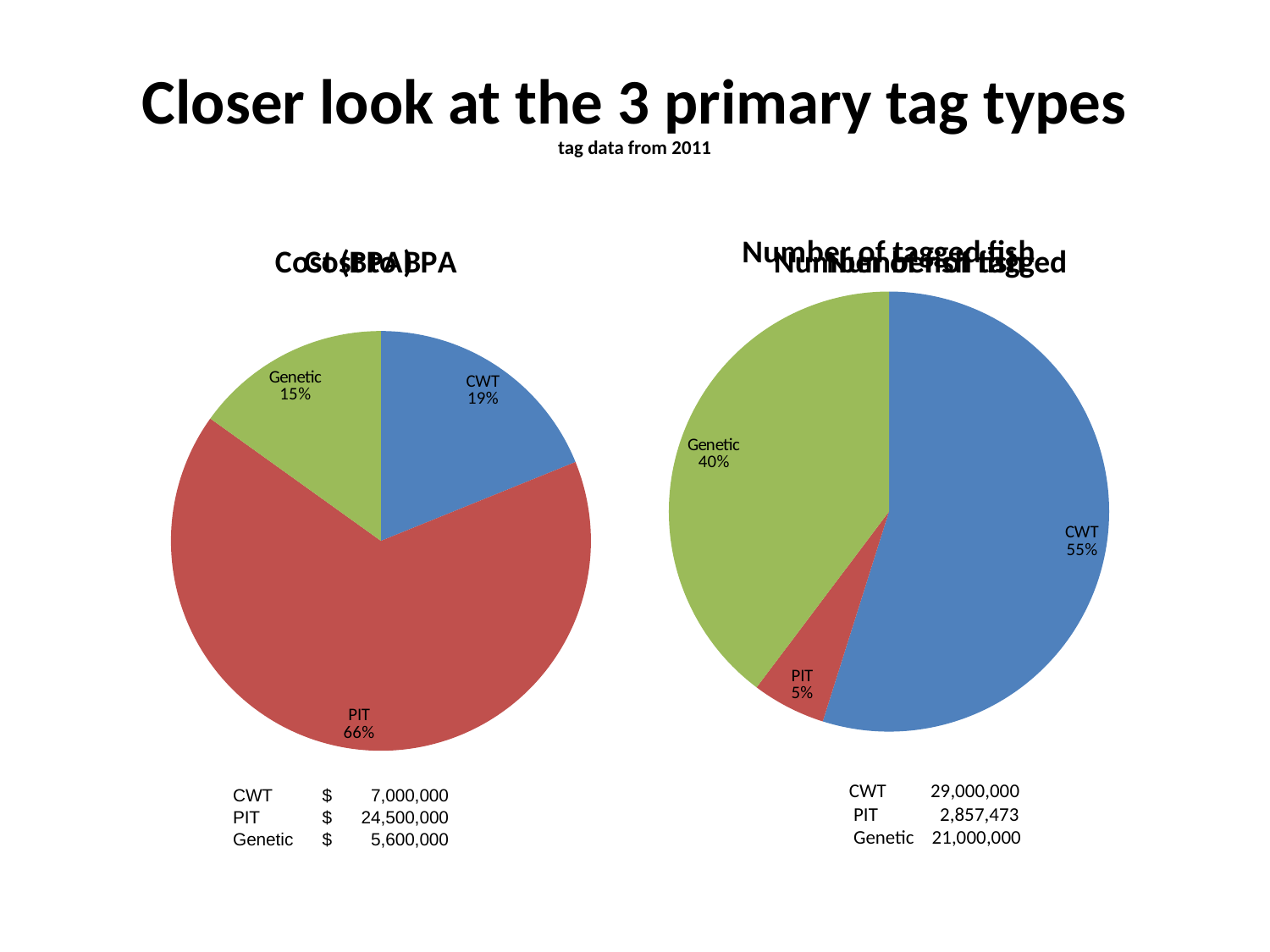
In the left pie chart, which tag type has the largest slice? PIT In the right pie chart, what share does CWT have? 55% In the right pie chart, what share does PIT have? 5% How many slices does the left pie chart have? 3 In the left pie chart, what is the difference in percentage points between the PIT share and the CWT share? 47 In the left pie chart, what share does Genetic have? 15% In the right pie chart, which slice is larger, Genetic or PIT? Genetic In the right pie chart, which tag type has the largest slice? CWT In the right pie chart, which tag type has the smallest slice? PIT In the left pie chart, which tag type has the smallest slice? Genetic What kind of chart is the chart on the left of the slide? pie chart